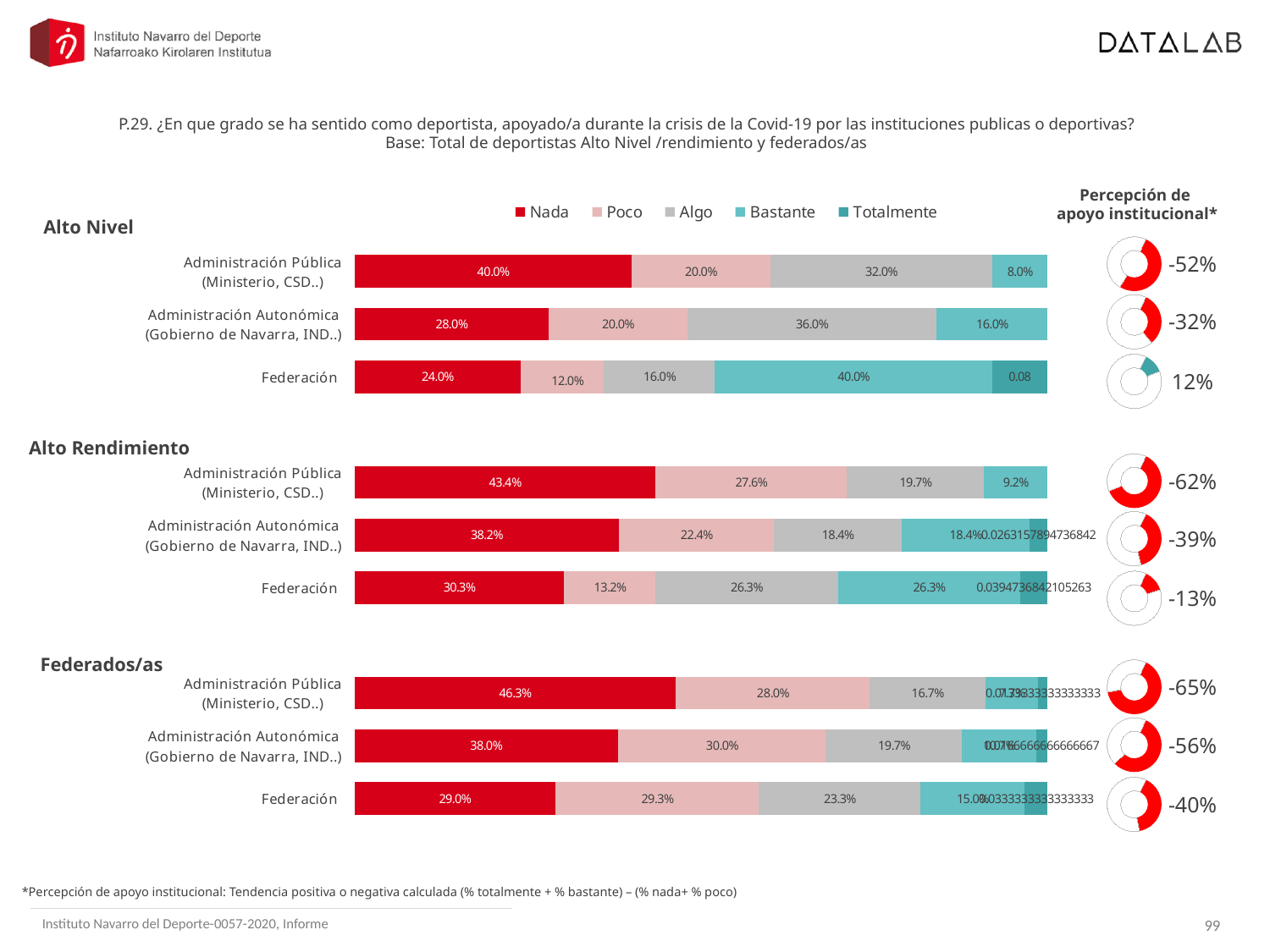
What kind of chart is used to show the responses for each group? Stacked bar chart In the Alto Rendimiento chart, which category has the highest Nada value? Administración Pública (Ministerio, CSD..) In the Alto Nivel chart, what is the difference between the Algo values for Administración Autonómica and Administración Pública? 4.0% In the Federados/as chart, what is the Nada value for Administración Autonómica (Gobierno de Navarra, IND..)? 38.0% In the Alto Nivel chart, what is the Bastante value for Federación? 40.0% In the Alto Nivel chart, which category has the lowest Nada value? Federación In the Federados/as chart, is the Nada value larger for Administración Pública or for Federación? Administración Pública How many categories are shown in the Alto Rendimiento chart? 3 In the Alto Nivel chart, what is the Nada value for Administración Pública (Ministerio, CSD..)? 40.0% How many series does the legend list? 5 What is the Percepción de apoyo institucional value for Federación in the Federados/as group? -40% In the Alto Rendimiento chart, what is the Poco value for Administración Pública (Ministerio, CSD..)? 27.6%